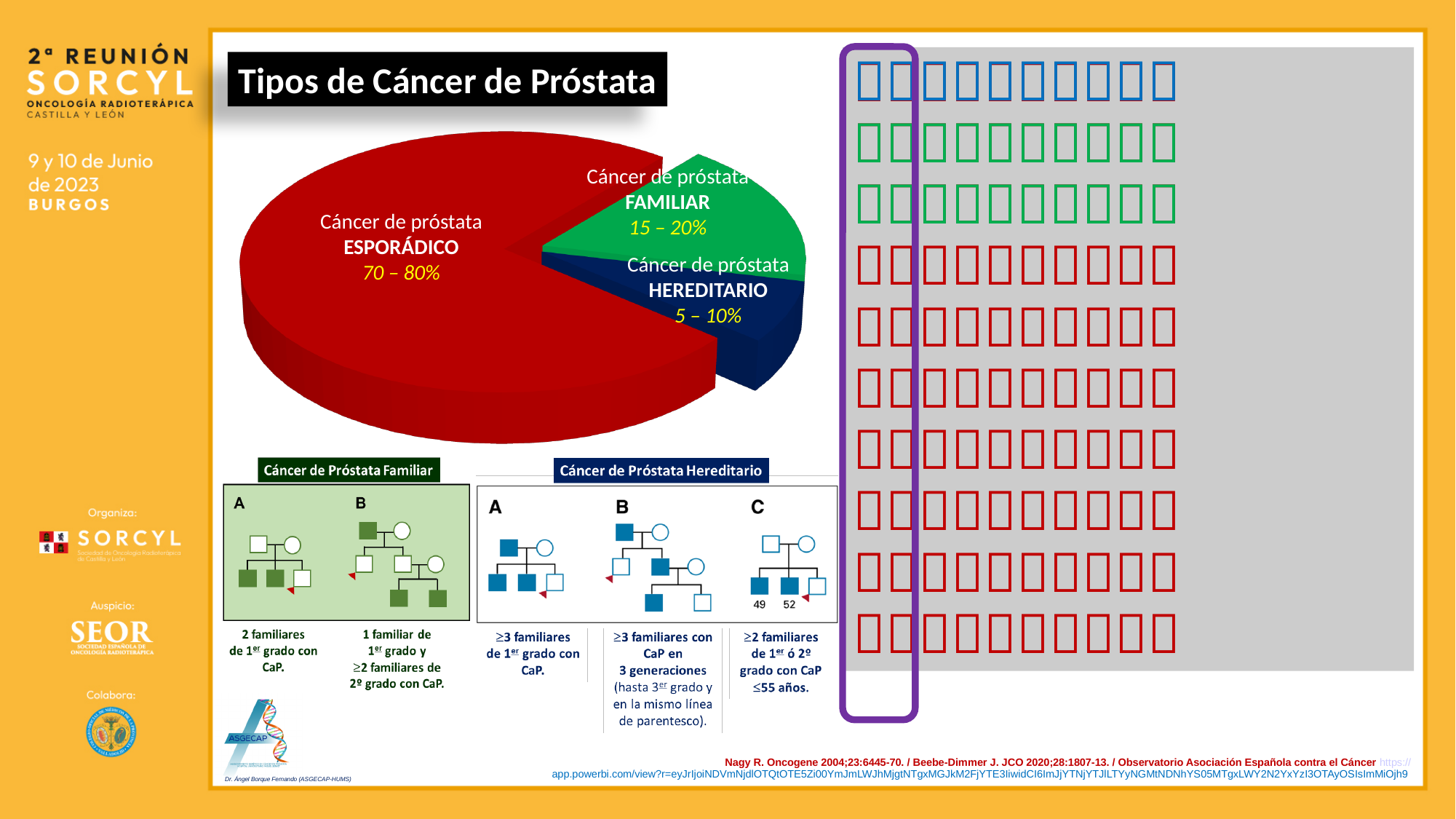
In the grid of squares on the right of the slide, how many rows of red squares are there? 7 What colour is the ESPORÁDICO slice in the pie chart? red In the pie chart, which slice is larger: FAMILIAR or HEREDITARIO? FAMILIAR How many slices does the pie chart have? 3 In the pie chart, which slice is larger: ESPORÁDICO or FAMILIAR? ESPORÁDICO What kind of chart is used to show the types of prostate cancer on the slide? pie chart Which type of prostate cancer has the largest slice in the pie chart? Cáncer de próstata ESPORÁDICO What percentage range is shown for Cáncer de próstata ESPORÁDICO in the pie chart? 70 – 80% What percentage range is shown for Cáncer de próstata HEREDITARIO in the pie chart? 5 – 10% Which type of prostate cancer has the smallest slice in the pie chart? Cáncer de próstata HEREDITARIO What colour is the HEREDITARIO slice in the pie chart? dark blue What percentage range is shown for Cáncer de próstata FAMILIAR in the pie chart? 15 – 20%